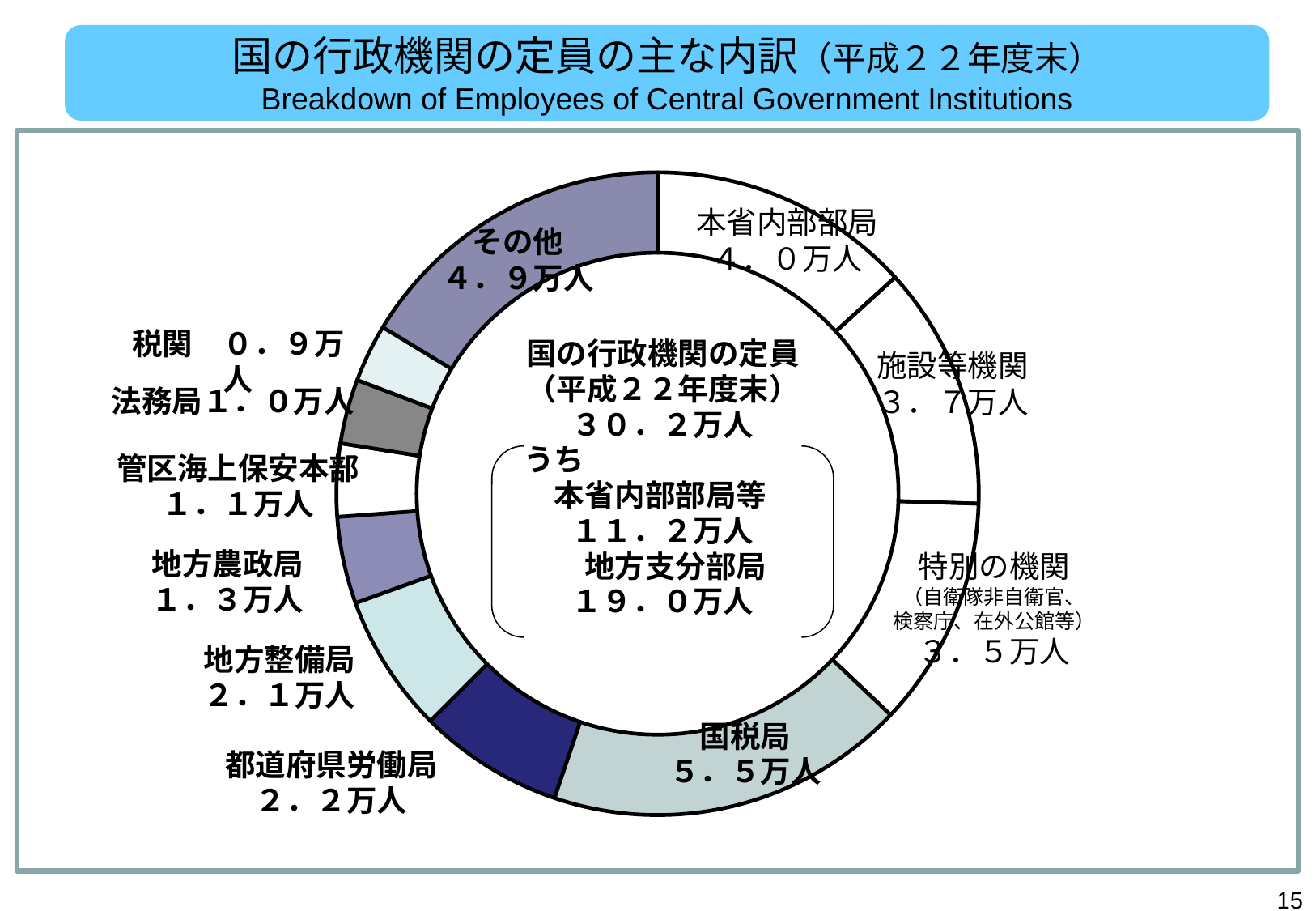
What is the value shown for 特別の機関? 3.5万人 What is the difference between 国税局 and 本省内部部局? 1.5万人 Which segment has the smallest value? 税関 How many segments does the doughnut chart have? 11 What is the value shown for 地方支分部局 in the centre of the chart? 19.0万人 Which segment has the largest value? 国税局 What total is shown in the centre of the chart for 国の行政機関の定員 (平成22年度末)? 30.2万人 What is the value shown for 国税局? 5.5万人 What is the value shown for 税関? 0.9万人 What is the value shown for 本省内部部局? 4.0万人 Which is larger, 施設等機関 or 特別の機関? 施設等機関 What kind of chart is shown on the slide? Doughnut (pie) chart